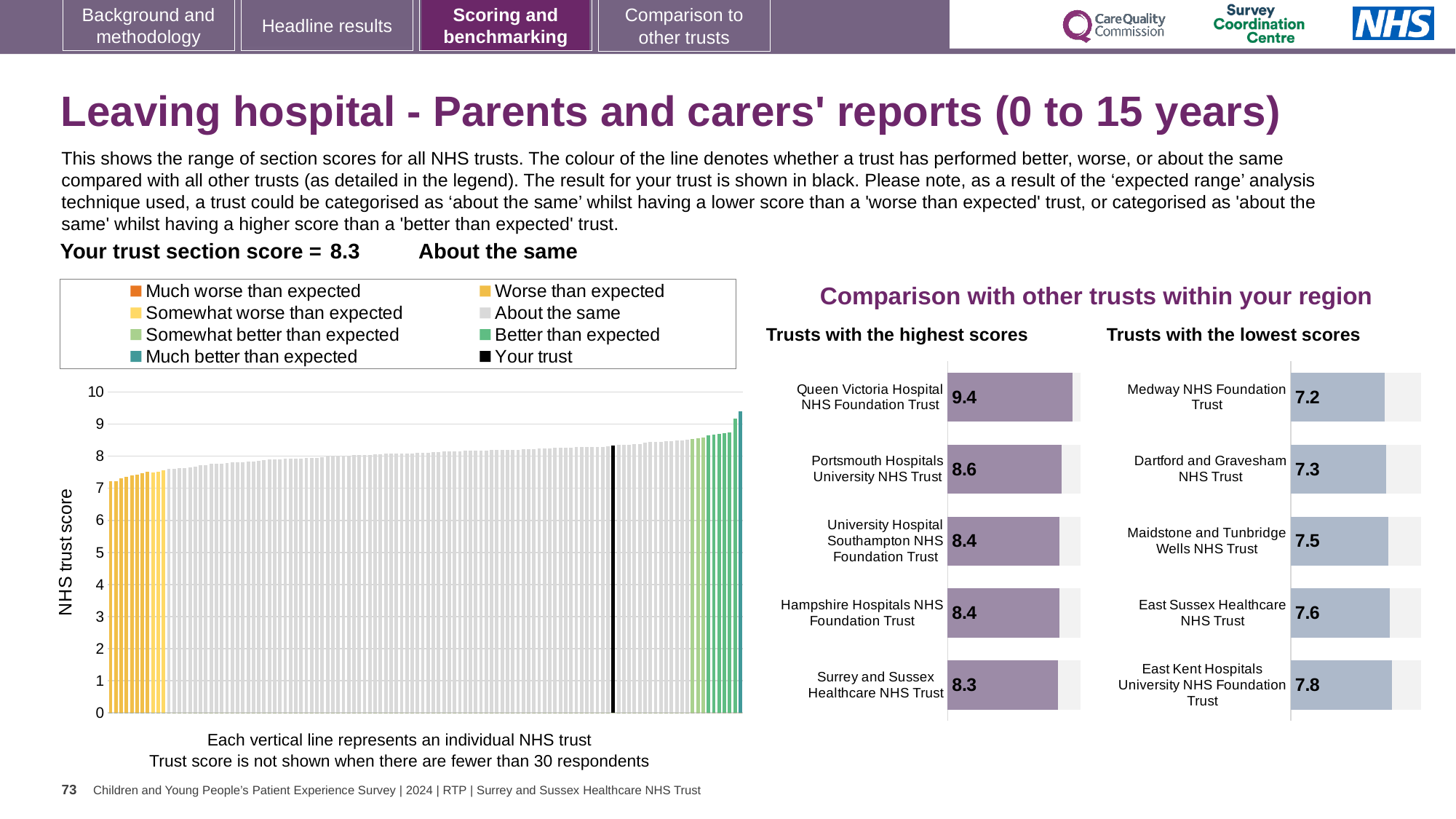
In the 'Trusts with the lowest scores' chart, which trust has the lowest score? Medway NHS Foundation Trust How many trusts are shown in the 'Trusts with the lowest scores' chart? 5 In the 'Trusts with the lowest scores' chart, which has the larger score: Dartford and Gravesham NHS Trust or Maidstone and Tunbridge Wells NHS Trust? Maidstone and Tunbridge Wells NHS Trust How many entries does the legend of the left-hand chart of all NHS trusts list? 8 In the left-hand chart of all NHS trusts, do the scores rise or fall from left to right? rise In the 'Trusts with the highest scores' chart, what is the difference between the scores of Queen Victoria Hospital NHS Foundation Trust and Surrey and Sussex Healthcare NHS Trust? 1.1 In the 'Trusts with the lowest scores' chart, what is the score for East Kent Hospitals University NHS Foundation Trust? 7.8 What is the section score for your trust shown in the left-hand chart of all NHS trusts? 8.3 In the 'Trusts with the lowest scores' chart, what is the score for Medway NHS Foundation Trust? 7.2 In the 'Trusts with the highest scores' chart, what is the score for Queen Victoria Hospital NHS Foundation Trust? 9.4 In the 'Trusts with the highest scores' chart, which trust has the highest score? Queen Victoria Hospital NHS Foundation Trust In the 'Trusts with the highest scores' chart, what is the score for Portsmouth Hospitals University NHS Trust? 8.6